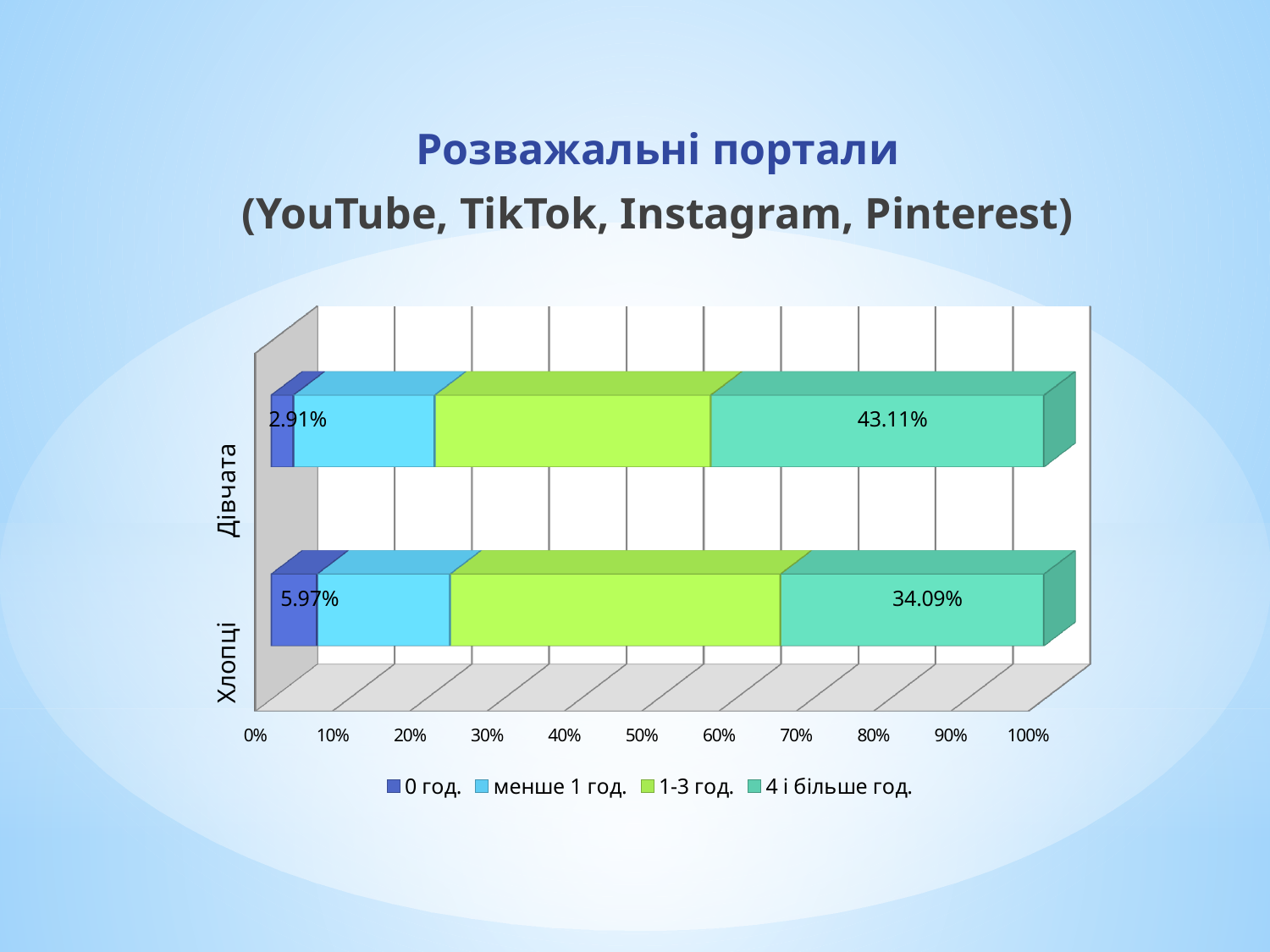
What is the value for 0 год. for Дівчата? 2.91% Which group has the larger value for 4 і більше год., Дівчата or Хлопці? Дівчата What is the difference between the 4 і більше год. values for Дівчата and Хлопці? 9.02% How many groups (categories) are shown on the chart? 2 What is the value for 0 год. for Хлопці? 5.97% What kind of chart is shown on the slide? Stacked bar chart What is the value for 4 і більше год. for Хлопці? 34.09% What is the difference between the 0 год. values for Хлопці and Дівчата? 3.06% Is the value for менше 1 год. for Хлопці greater or less than 30%? less How many series does the legend list? 4 Which group has the larger value for 0 год., Дівчата or Хлопці? Хлопці What is the value for 4 і більше год. for Дівчата? 43.11%